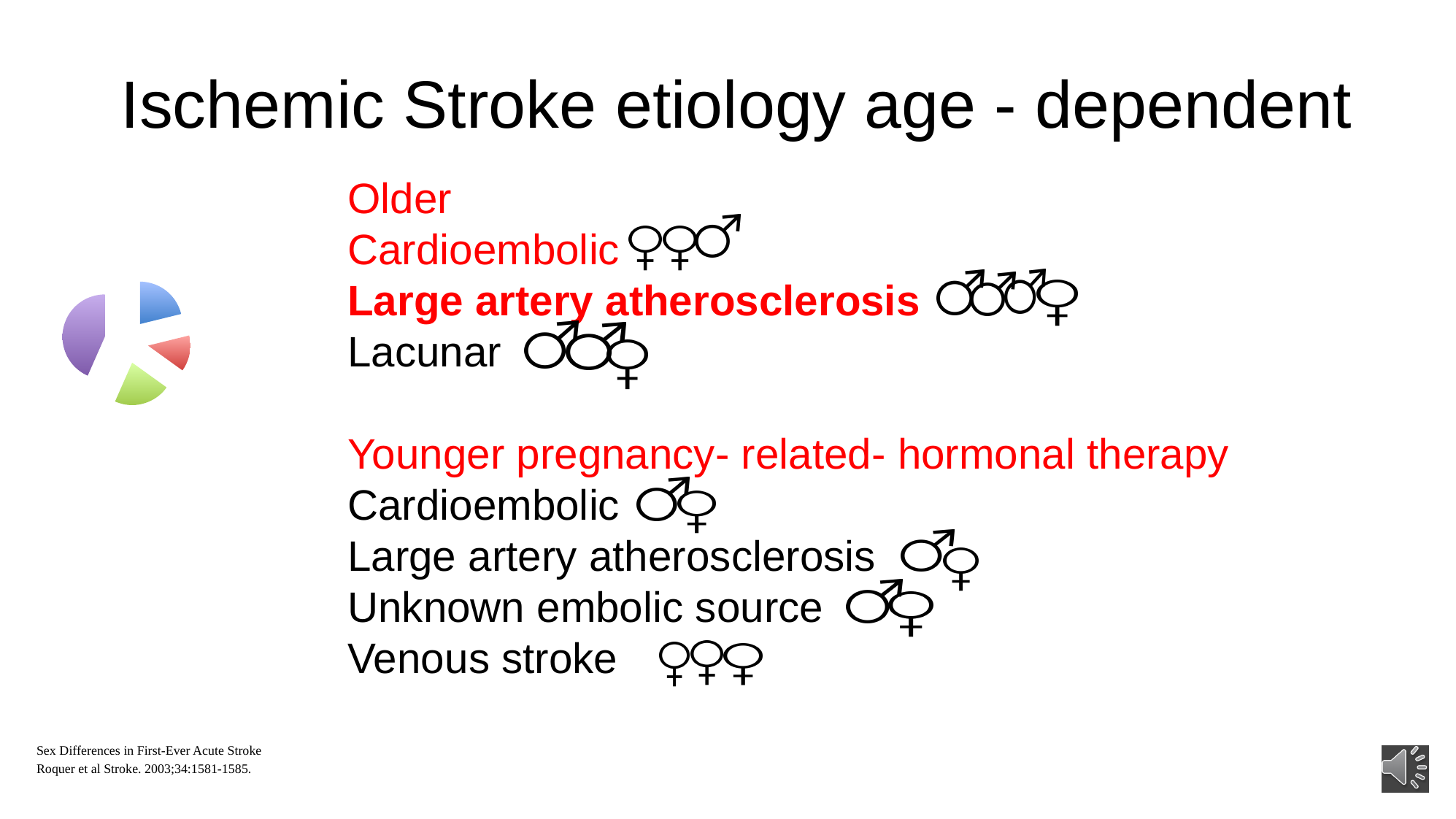
Does the pie chart on the left of the slide display data labels on its slices? No What kind of chart is shown on the left of the slide? pie chart Does the pie chart on the left of the slide show a legend? No How many slices does the pie chart on the left of the slide have? 4 Which colour slice is the largest in the pie chart on the left of the slide? purple